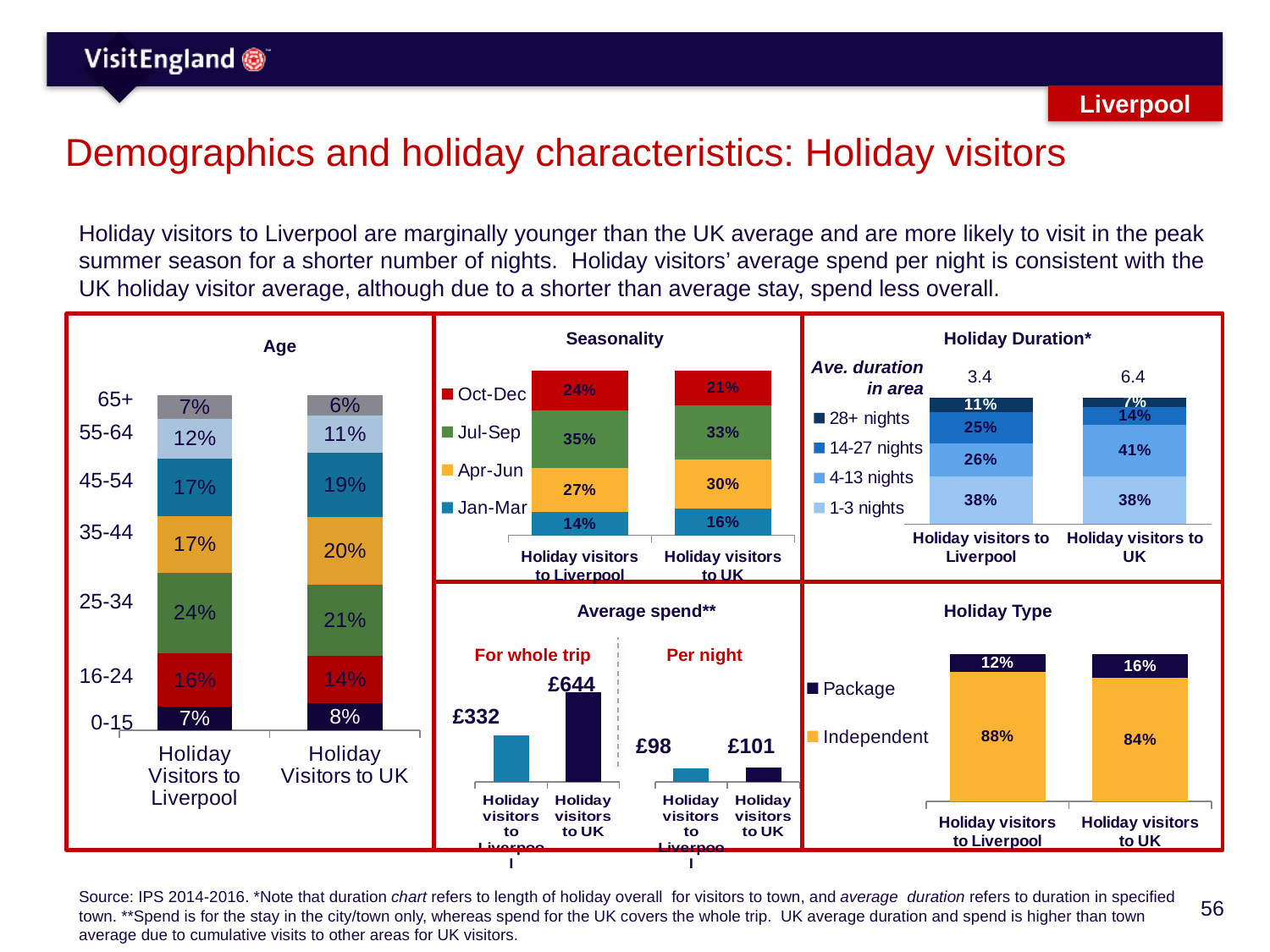
In the Holiday Type chart, what percentage of holiday visitors to Liverpool are on a package holiday? 12% In the Seasonality chart, what percentage of holiday visitors to Liverpool visit in Jul-Sep? 35% In the Age chart, which age group has the largest share among holiday visitors to UK? 25-34 In the Average spend chart, what is the difference in per night spend between holiday visitors to UK and holiday visitors to Liverpool? £3 In the Age chart, what percentage of holiday visitors to Liverpool are aged 25-34? 24% In the Average spend chart, what is the spend for the whole trip for holiday visitors to UK? £644 In the Seasonality chart, which quarter has the smallest share for holiday visitors to UK? Jan-Mar In the Holiday Duration chart, what percentage of holiday visitors to UK stay 4-13 nights? 41% What kind of chart is the Holiday Type chart? Stacked bar chart How many series does the legend of the Seasonality chart list? 4 In the Age chart, what is the difference between the 16-24 share for holiday visitors to Liverpool and for holiday visitors to UK? 2% In the Holiday Duration chart, what is the average duration in area for holiday visitors to Liverpool? 3.4